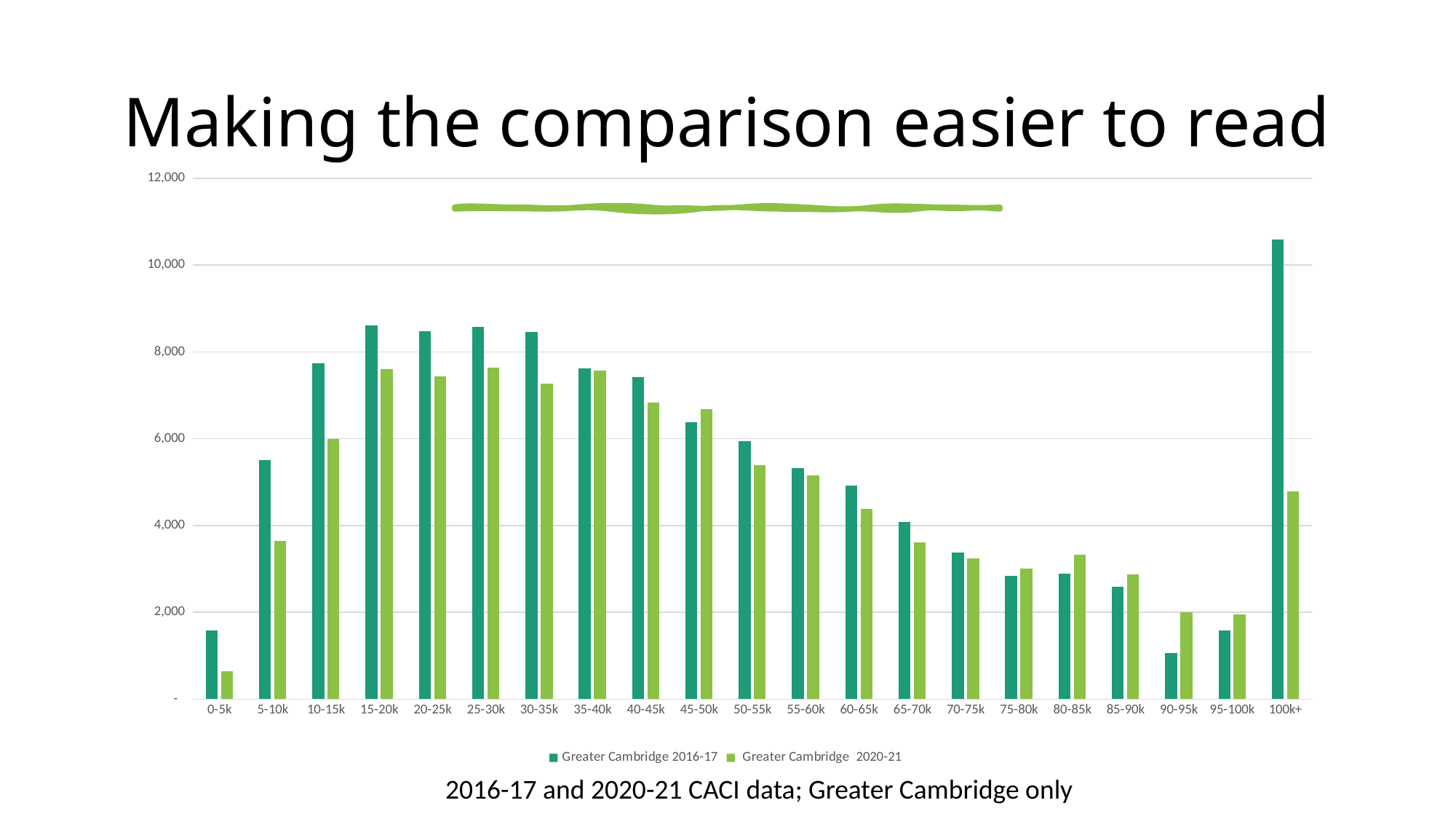
Is the Greater Cambridge 2016-17 value for 100k+ greater or less than 10,000? greater How many series does the legend list? 2 Do the Greater Cambridge 2016-17 values rise or fall from 30-35k to 65-70k? fall Which category has the lowest value for Greater Cambridge 2020-21? 0-5k Which category has the lowest value for Greater Cambridge 2016-17? 90-95k What kind of chart is shown on the slide? bar chart For the 90-95k category, which series has the larger value, Greater Cambridge 2016-17 or Greater Cambridge 2020-21? Greater Cambridge 2020-21 How many income band categories are shown on the x axis? 21 For the 100k+ category, which series has the larger value, Greater Cambridge 2016-17 or Greater Cambridge 2020-21? Greater Cambridge 2016-17 Which category has the highest value for Greater Cambridge 2016-17? 100k+ Is the Greater Cambridge 2020-21 value for 100k+ greater or less than 6,000? less Is the Greater Cambridge 2020-21 value for 0-5k greater or less than 2,000? less